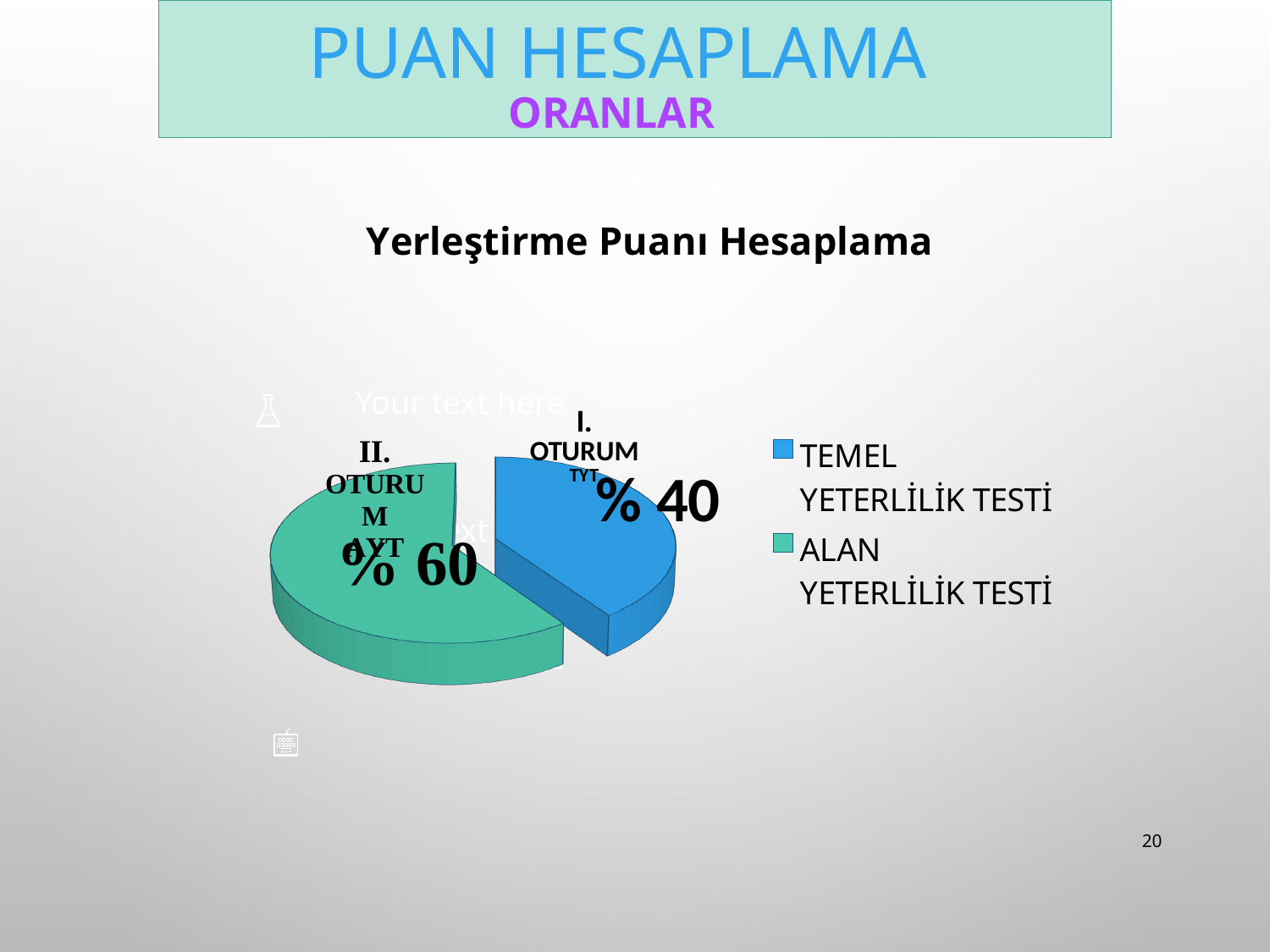
Which slice of the pie chart is the smallest? I. OTURUM TYT Which slice of the pie chart is the largest? II. OTURUM AYT What share of the pie does the ALAN YETERLİLİK TESTİ (II. OTURUM AYT) slice represent? % 60 How many entries does the legend list? 2 What is the value shown for the II. OTURUM AYT slice? % 60 Which is larger, the I. OTURUM TYT slice or the II. OTURUM AYT slice? II. OTURUM AYT What is the value shown for the I. OTURUM TYT slice? % 40 What is the title of the chart? Yerleştirme Puanı Hesaplama What kind of chart is shown on the slide? Pie chart Which legend entry is shown in blue? TEMEL YETERLİLİK TESTİ How many slices does the pie chart have? 2 What is the difference between the II. OTURUM AYT value and the I. OTURUM TYT value? % 20